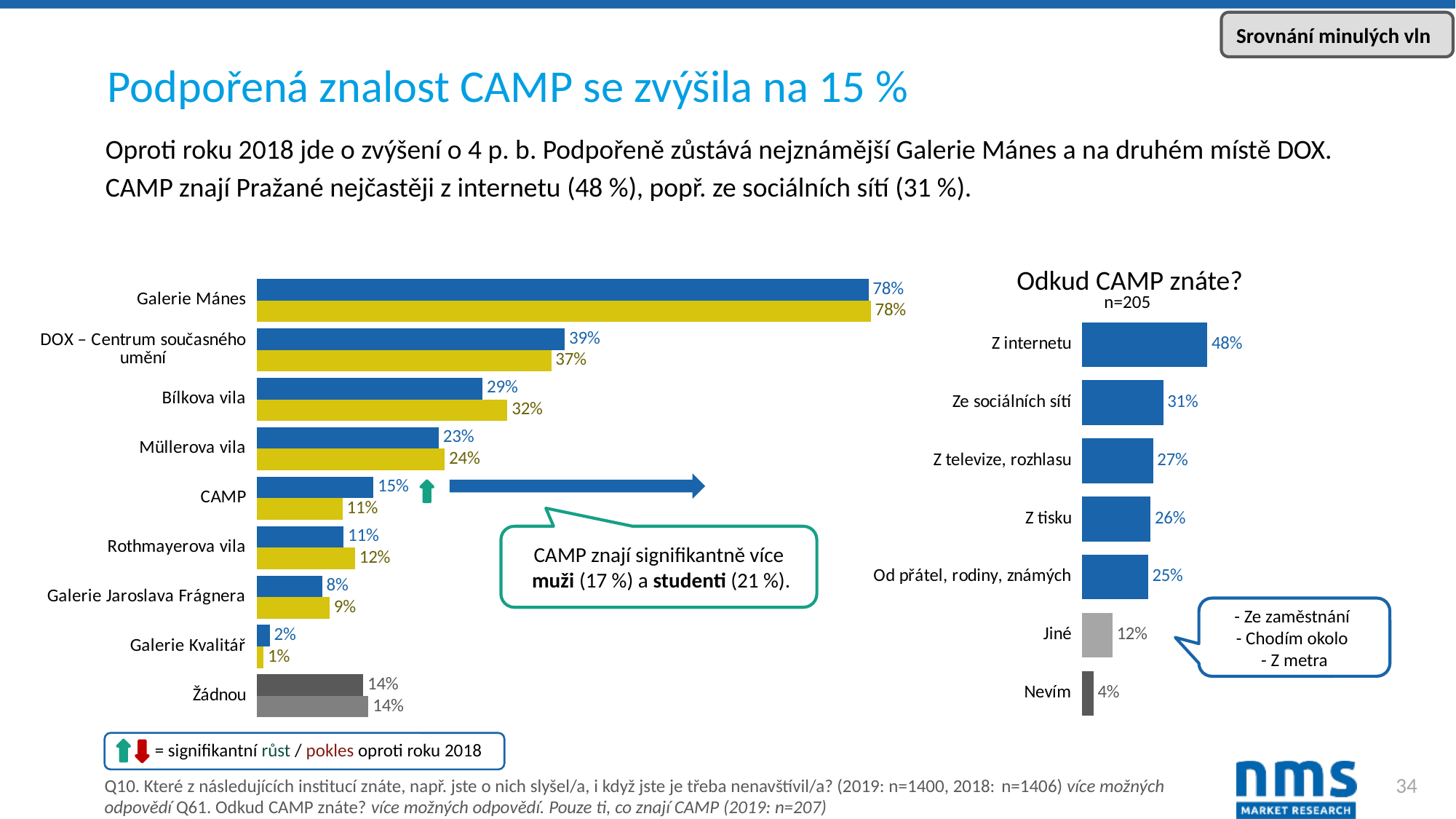
What kind of chart is the chart titled 'Odkud CAMP znáte?'? bar chart In the chart titled 'Odkud CAMP znáte?', what is the value for 'Z internetu'? 48% In the chart titled 'Odkud CAMP znáte?', which category has the lowest value? Nevím In the chart titled 'Odkud CAMP znáte?', how many categories are shown? 7 In the left chart of institutions, what is the value of the blue bar for 'Bílkova vila'? 29% In the left chart of institutions, what is the value of the yellow bar for 'DOX – Centrum současného umění'? 37% In the chart titled 'Odkud CAMP znáte?', which category has the highest value? Z internetu In the left chart of institutions, what is the difference between the blue and yellow bars for 'CAMP'? 4% In the chart titled 'Odkud CAMP znáte?', what is the difference between 'Ze sociálních sítí' and 'Z tisku'? 5% In the left chart of institutions, how many categories are listed on the vertical axis? 9 In the left chart of institutions, what is the value of the blue bar for 'Galerie Mánes'? 78% In the left chart of institutions, which bar is larger for 'Müllerova vila', the blue or the yellow one? yellow